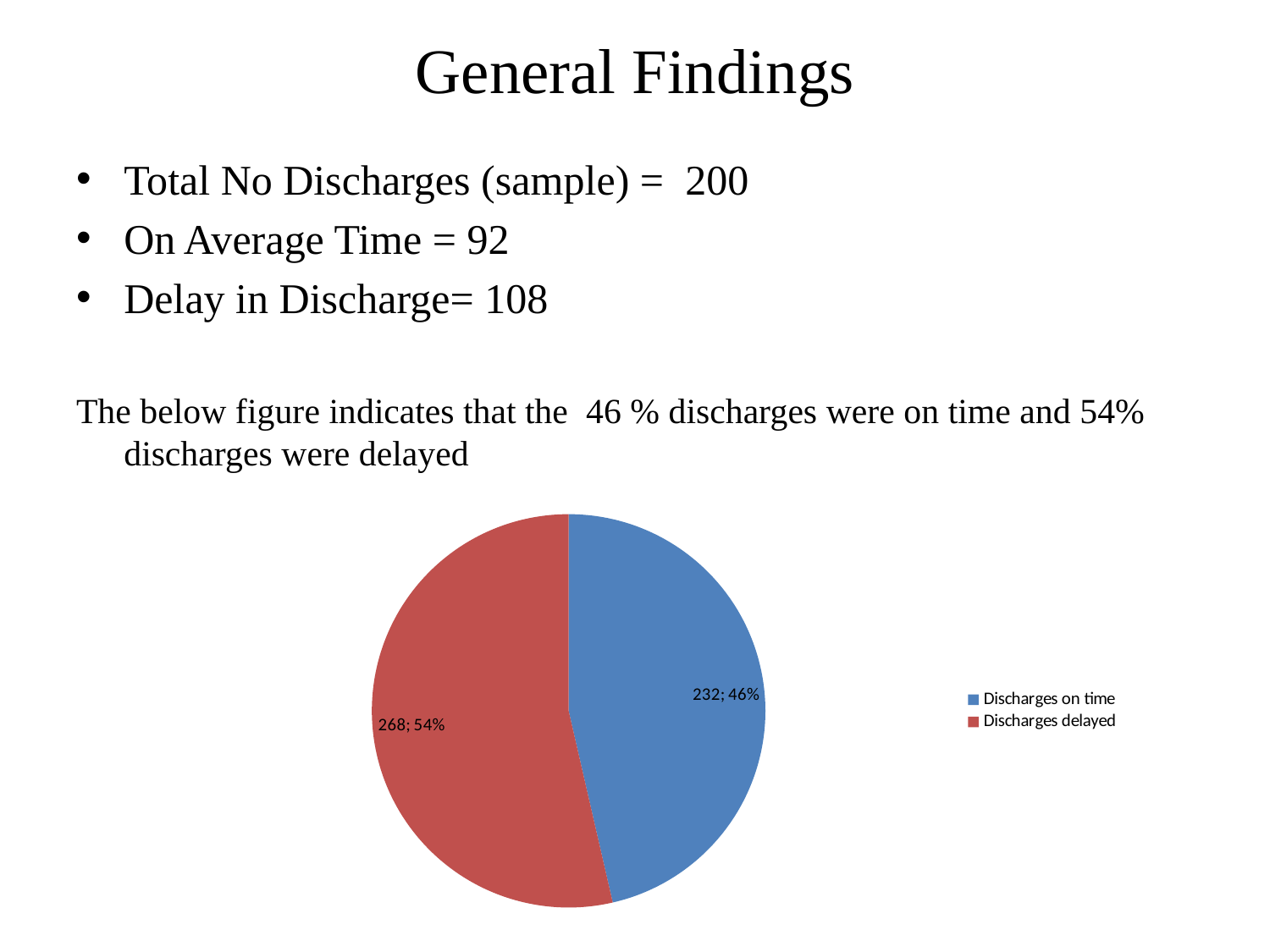
What is the difference between the values for Discharges delayed and Discharges on time? 36 Which is larger, Discharges on time or Discharges delayed? Discharges delayed Which slice is the smallest in the pie chart? Discharges on time Which slice is the largest in the pie chart? Discharges delayed What colour is the Discharges delayed slice? red What kind of chart is shown on the slide? pie chart How many slices does the pie chart have? 2 What value is shown for Discharges on time? 232 What percentage share of the pie is Discharges on time? 46% What value is shown for Discharges delayed? 268 What percentage share of the pie is Discharges delayed? 54% What is the total of the two slice values in the pie chart? 500